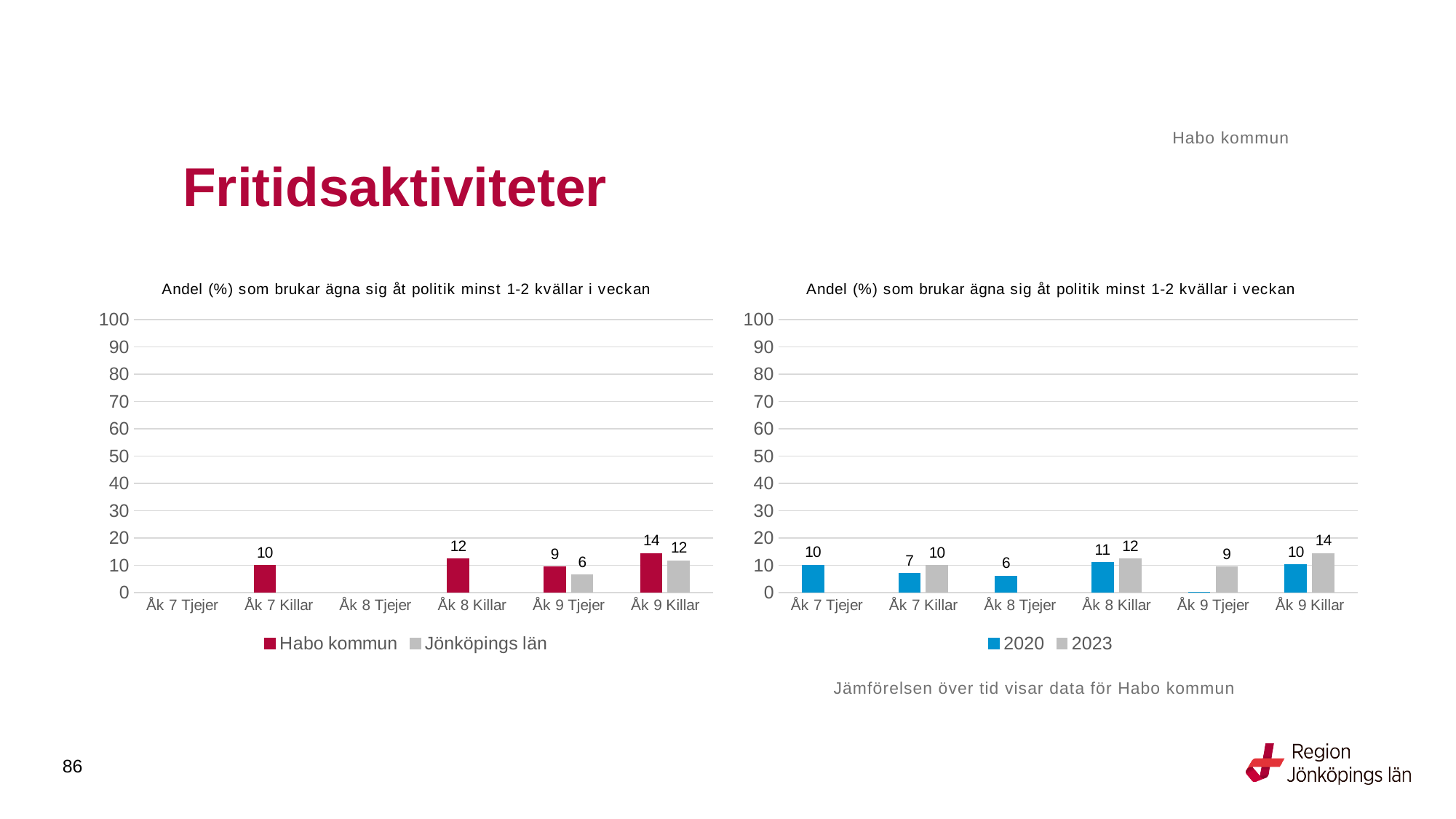
In the right chart, what is the 2020 value for Åk 8 Tjejer? 6 In the left chart, what is the difference between Habo kommun and Jönköpings län for Åk 9 Tjejer? 3 In the left chart, which category has the highest Habo kommun value? Åk 9 Killar In the right chart, which is larger for Åk 7 Killar, the 2020 value or the 2023 value? 2023 In the left chart, what is the value for Habo kommun for Åk 9 Killar? 14 In the right chart, is the 2020 value for Åk 8 Killar greater or less than 20? less What kind of chart is the left chart? bar chart In the right chart, what is the 2023 value for Åk 9 Killar? 14 How many categories are shown on the x axis of the right chart? 6 In the right chart, what is the difference between the 2023 and 2020 values for Åk 9 Killar? 4 In the left chart, what is the value for Jönköpings län for Åk 9 Tjejer? 6 In the left chart, how many series does the legend list? 2